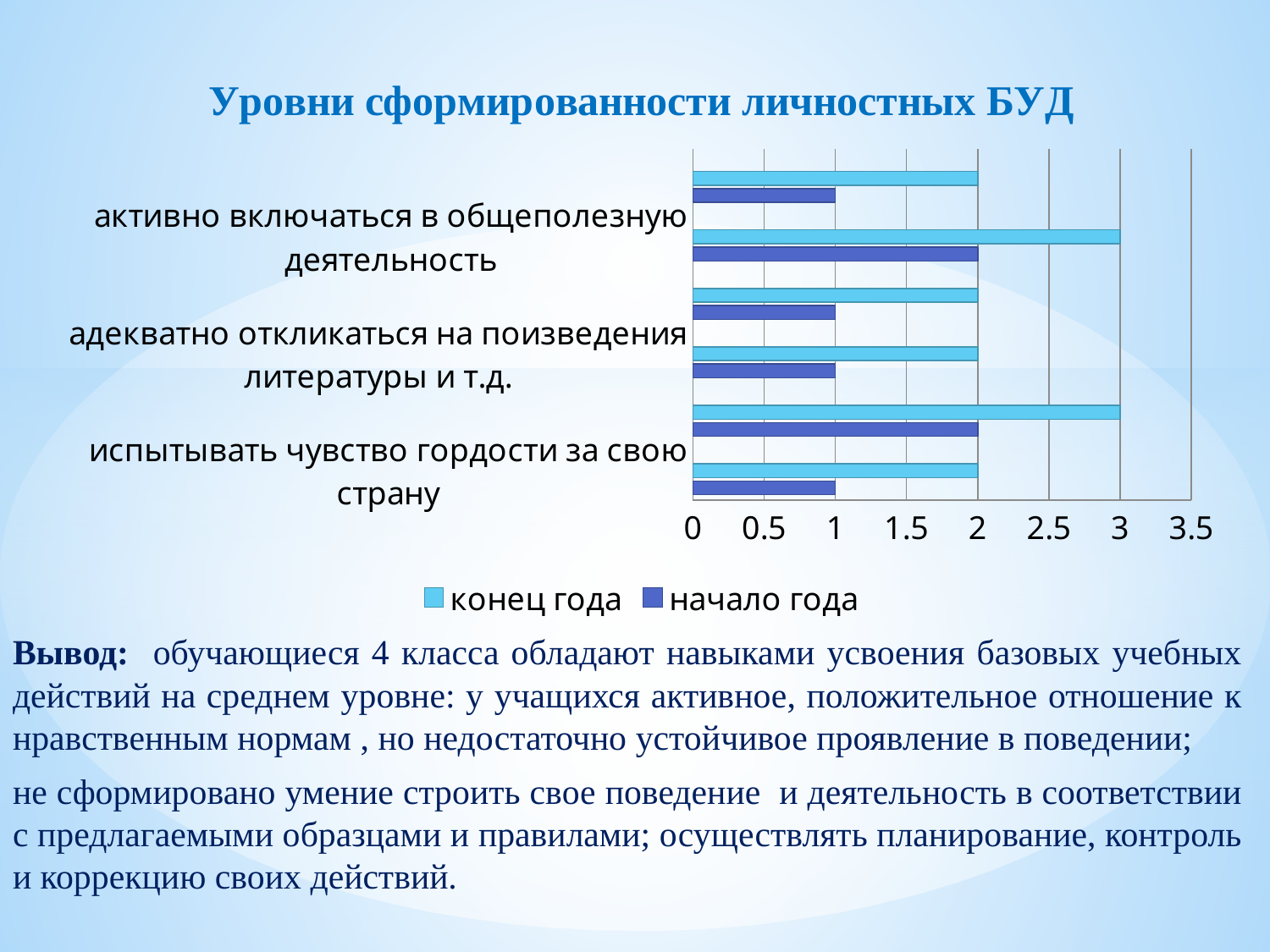
What is the value of 'конец года' for 'активно включаться в общеполезную деятельность'? 3 For 'активно включаться в общеполезную деятельность', which series has the larger value, 'конец года' or 'начало года'? конец года How many series does the legend list? 2 What are the two series named in the legend? конец года, начало года What is the difference between 'конец года' and 'начало года' for 'испытывать чувство гордости за свою страну'? 1 What is the title of the slide's chart? Уровни сформированности личностных БУД What is the highest value reached by any bar in the chart? 3 What kind of chart is shown on the slide? bar chart What is the value of 'начало года' for 'активно включаться в общеполезную деятельность'? 2 Is the value of 'конец года' for 'активно включаться в общеполезную деятельность' greater or less than 2.5? greater What is the value of 'начало года' for 'испытывать чувство гордости за свою страну'? 1 What is the value of 'конец года' for 'адекватно откликаться на поизведения литературы и т.д.'? 2